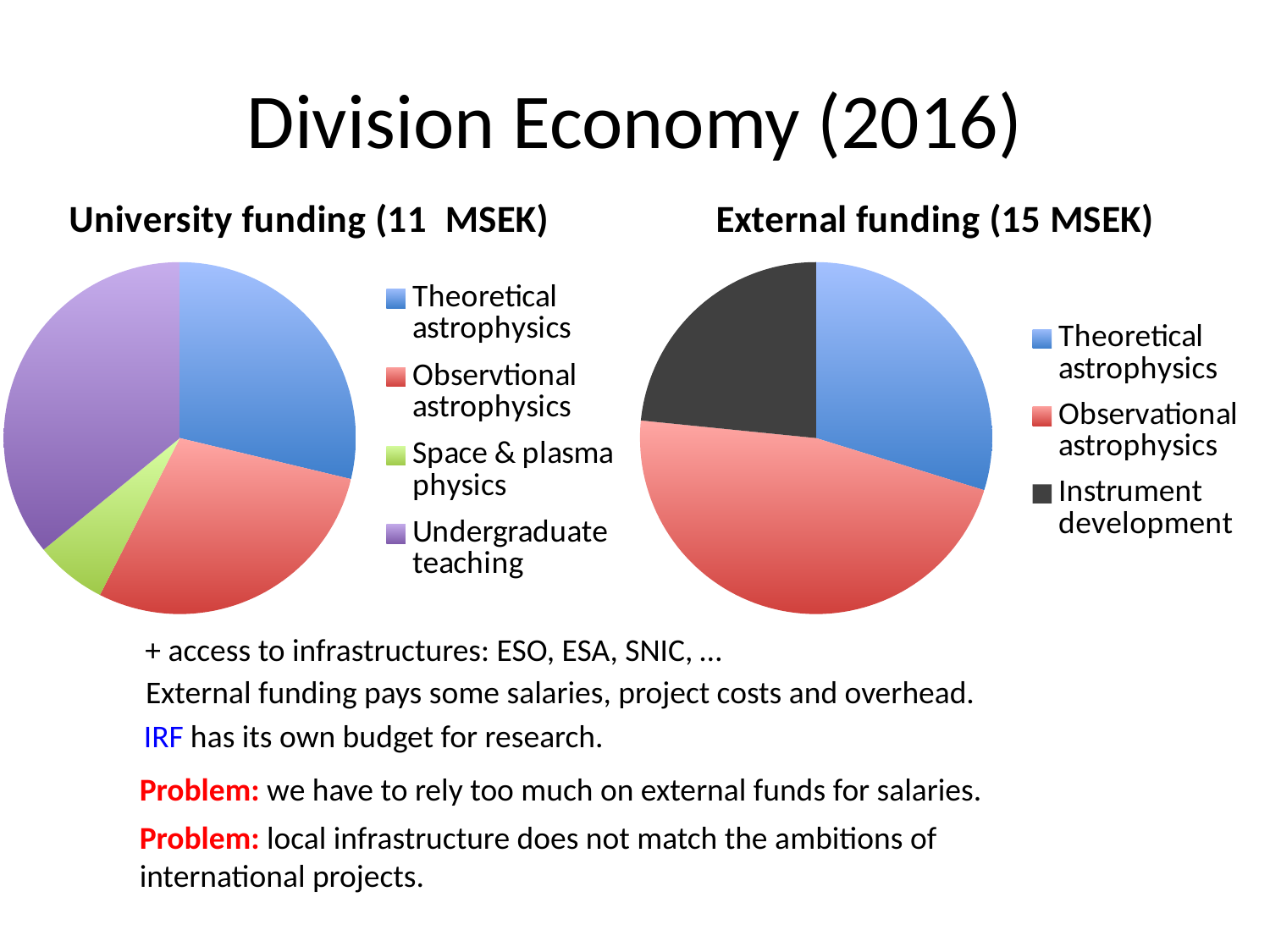
In the External funding (15 MSEK) chart, how many slices does the pie have? 3 What is the title of the pie chart on the right side of the slide? External funding (15 MSEK) What kind of chart is the External funding (15 MSEK) chart? Pie chart In the University funding (11 MSEK) chart, how many slices does the pie have? 4 In the University funding (11 MSEK) chart, which slice is larger: Theoretical astrophysics or Space & plasma physics? Theoretical astrophysics In the External funding (15 MSEK) chart, how many entries does the legend list? 3 In the External funding (15 MSEK) chart, which category has the smallest slice? Instrument development In the External funding (15 MSEK) chart, which slice is larger: Observational astrophysics or Instrument development? Observational astrophysics In the University funding (11 MSEK) chart, how many entries does the legend list? 4 In the University funding (11 MSEK) chart, which category has the smallest slice? Space & plasma physics What kind of chart is the University funding (11 MSEK) chart? Pie chart In the External funding (15 MSEK) chart, which category has the largest slice? Observational astrophysics